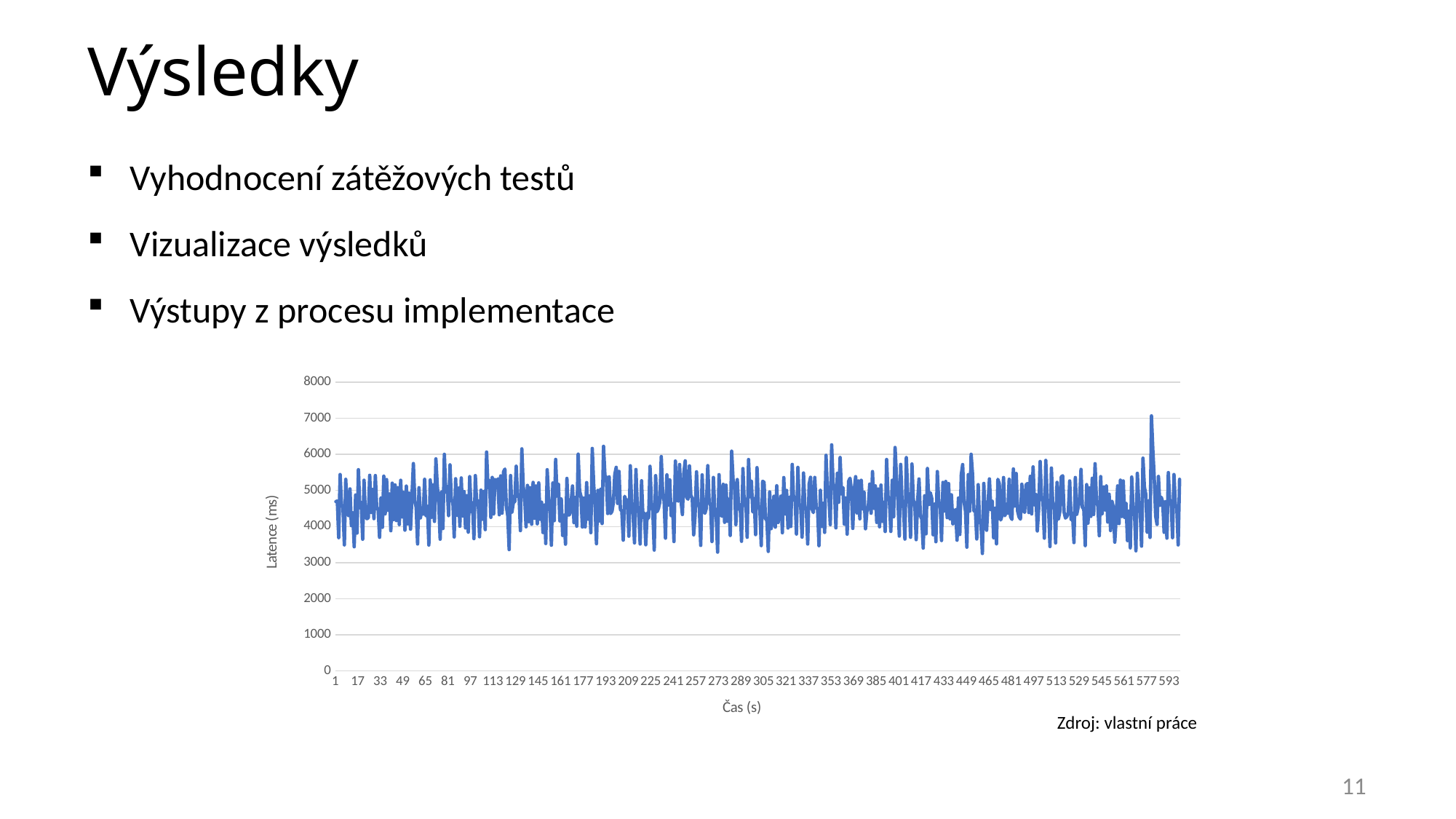
What is the label of the vertical axis of the chart? Latence (ms) How many data series are plotted in the chart? 1 Is the highest value plotted in the chart greater or less than 6000? greater Is the lowest value plotted in the chart greater or less than 3000? greater Is the highest value plotted in the chart greater or less than 8000? less What kind of chart is shown on the slide? line chart What is the label of the horizontal axis of the chart? Čas (s) What is the highest tick value shown on the vertical axis? 8000 Do the plotted values show a clear overall rise or fall along the x axis, or do they fluctuate around a roughly constant level? fluctuate around a roughly constant level